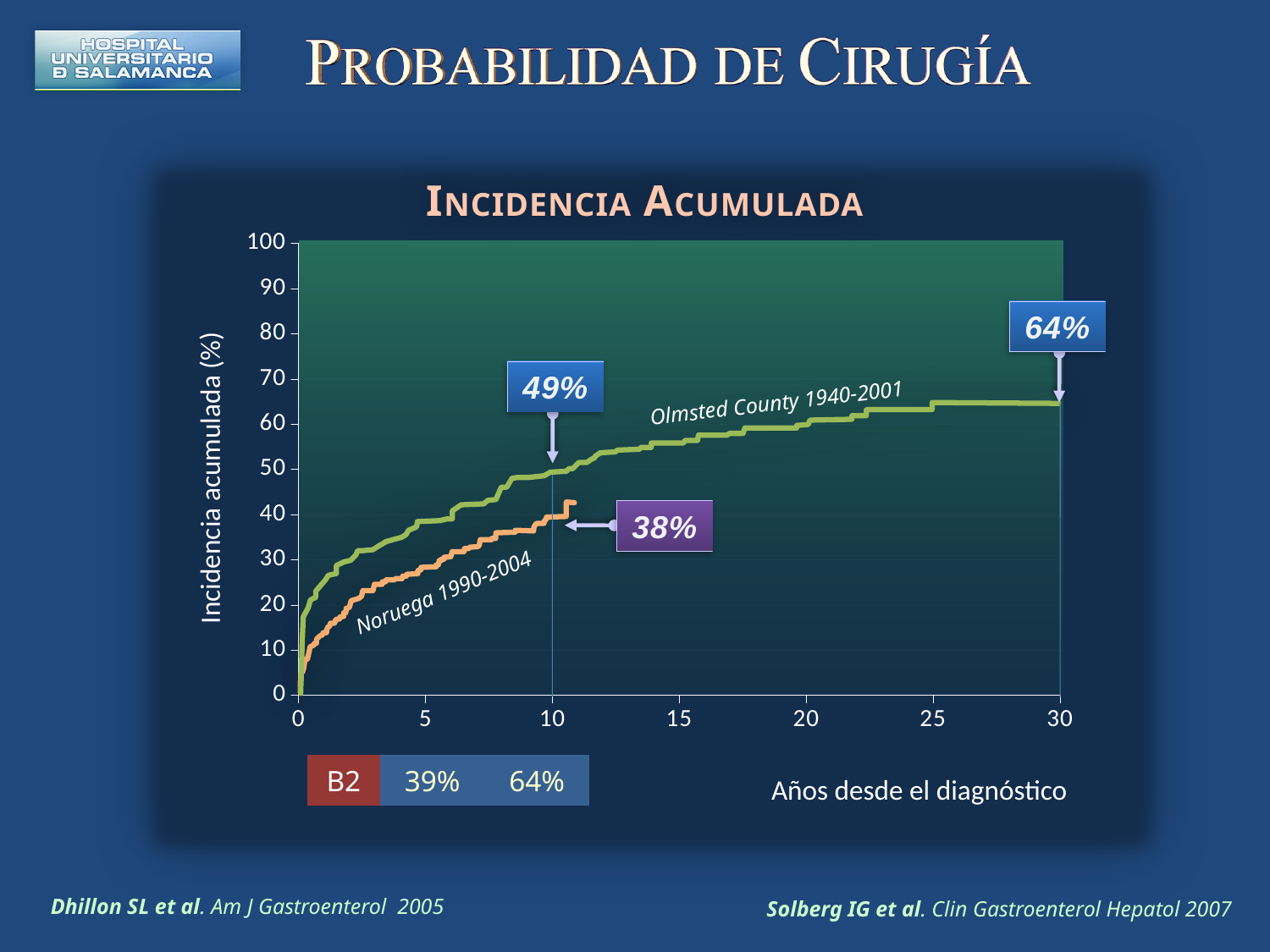
How many series are plotted on the chart? 2 Is the value for Olmsted County 1940-2001 at 20 years since diagnosis greater or less than 50? greater Does the cumulative incidence for Olmsted County 1940-2001 rise or fall as years since diagnosis increase? rise What is the cumulative incidence for Olmsted County 1940-2001 at 30 years since diagnosis? 64% What is the difference between the Olmsted County 1940-2001 value at 30 years and its value at 10 years? 15% What is the title of the chart? Incidencia Acumulada At 10 years since diagnosis, which series has the higher cumulative incidence, Olmsted County 1940-2001 or Noruega 1990-2004? Olmsted County 1940-2001 What is the label of the x axis? Años desde el diagnóstico What is the cumulative incidence for Noruega 1990-2004 at 10 years since diagnosis? 38% What is the cumulative incidence for Olmsted County 1940-2001 at 10 years since diagnosis? 49% What type of chart is shown on the slide? line chart What is the difference between the Olmsted County 1940-2001 and Noruega 1990-2004 values at 10 years since diagnosis? 11%